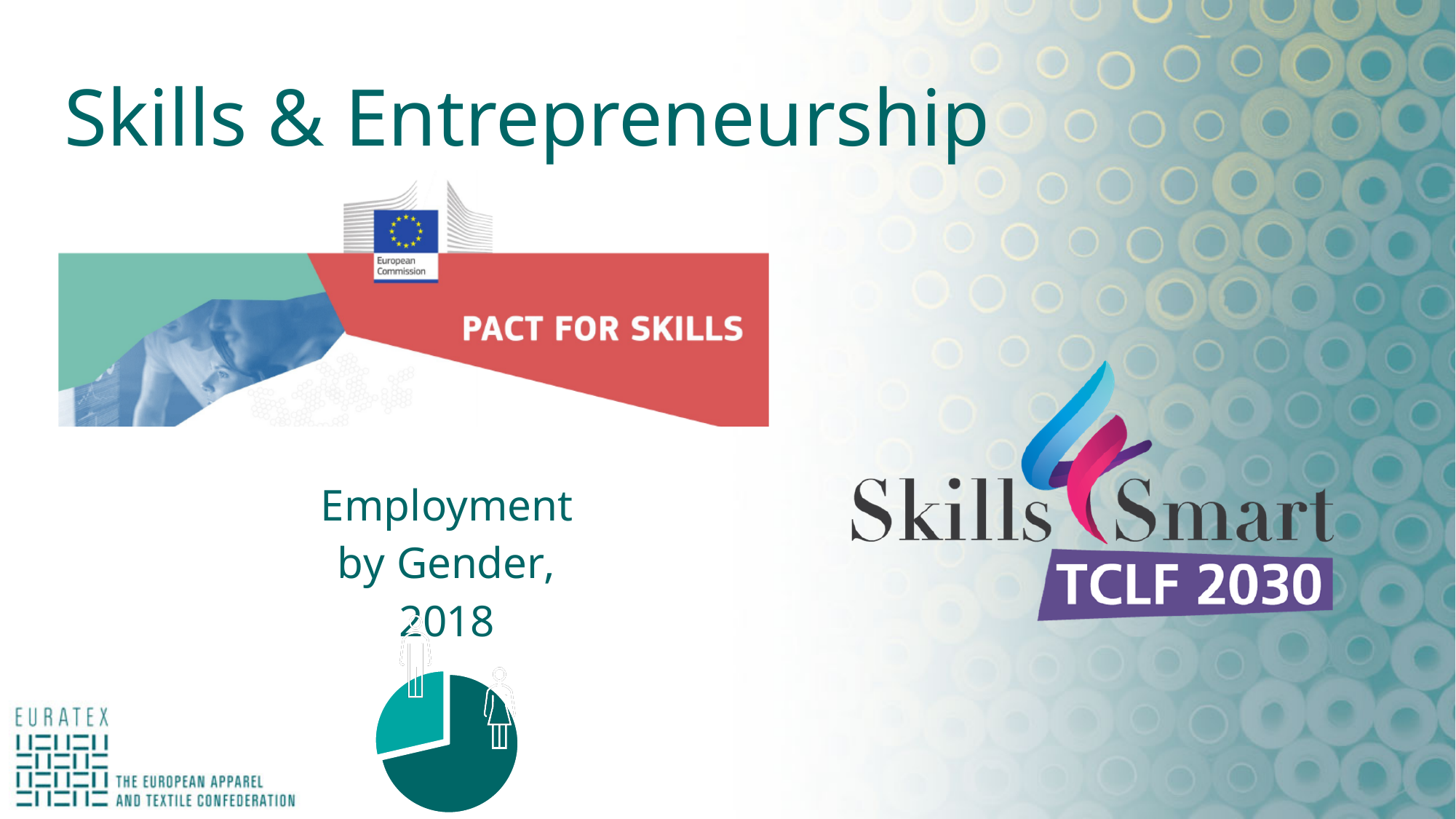
What kind of chart is shown at the bottom of the slide under the heading 'Employment by Gender, 2018'? pie chart In the 'Employment by Gender, 2018' pie chart, which slice is larger: the dark teal slice or the lighter teal slice? the dark teal slice How many slices does the 'Employment by Gender, 2018' pie chart have? 2 Does the 'Employment by Gender, 2018' pie chart show any numeric data labels on its slices? No In the 'Employment by Gender, 2018' pie chart, which slice is the smallest? the lighter teal slice What is the title shown above the pie chart on the slide? Employment by Gender, 2018